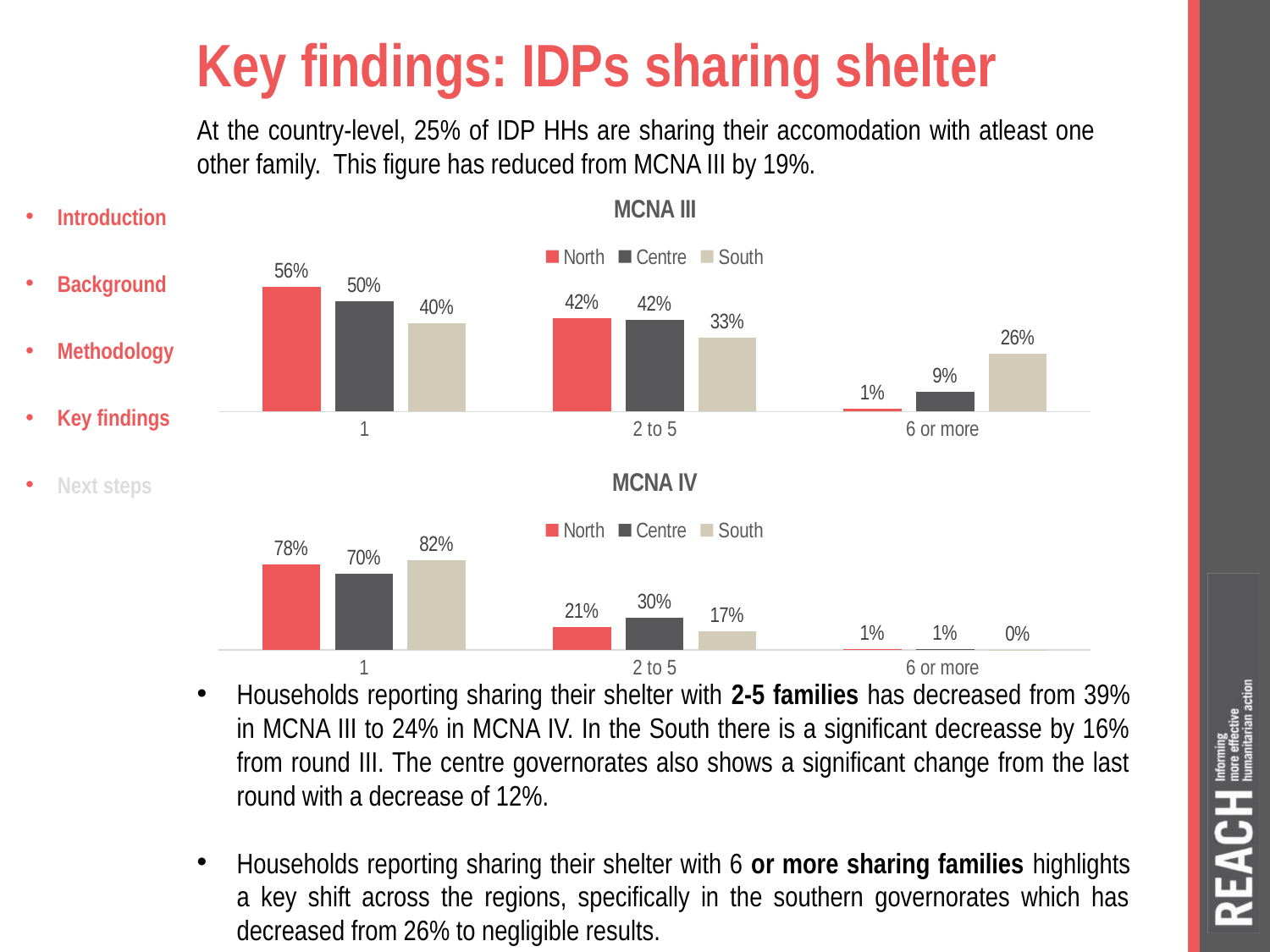
In the MCNA III chart, what is the value for North in the "1" category? 56% In the MCNA IV chart, what is the value for South in the "1" category? 82% How many categories are shown on the x axis of the MCNA IV chart? 3 In the MCNA IV chart, what is the difference between the Centre and South values in the "2 to 5" category? 13% In the MCNA III chart, what is the value for South in the "6 or more" category? 26% How many series does the legend of the MCNA III chart list? 3 In the MCNA III chart, is the Centre value in the "2 to 5" category larger or smaller than the South value? larger In the MCNA III chart, which region has the lowest value in the "6 or more" category? North What type of chart is the MCNA IV chart? bar chart In the MCNA IV chart, what is the value for Centre in the "2 to 5" category? 30% In the MCNA IV chart, which region has the highest value in the "1" category? South In the MCNA III chart, what is the difference between the North and South values in the "1" category? 16%